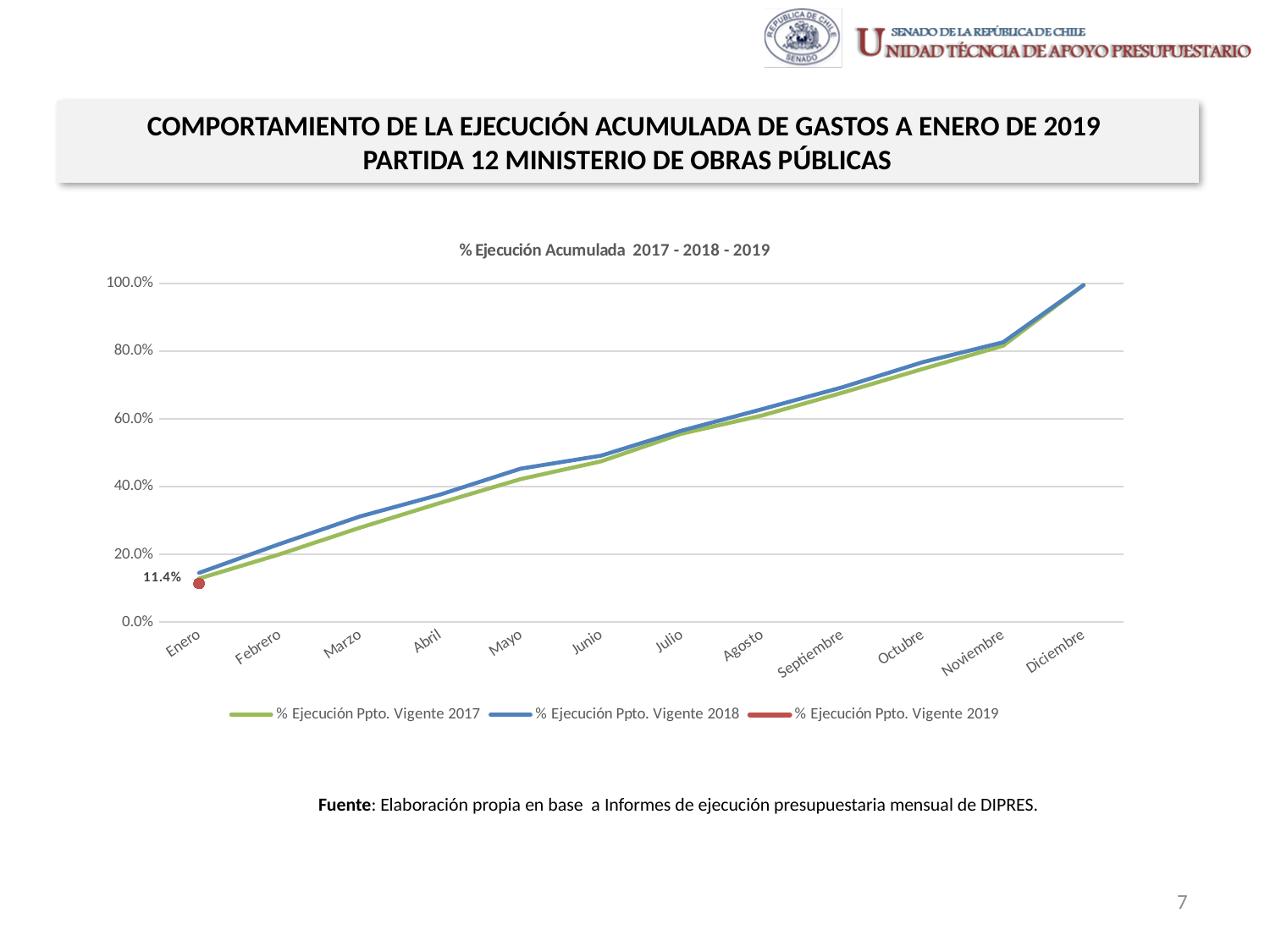
How many series does the legend list? 3 What kind of chart is shown on the slide? Line chart Do the values for % Ejecución Ppto. Vigente 2018 rise or fall from Enero to Diciembre? Rise In which month does % Ejecución Ppto. Vigente 2018 reach its highest value? Diciembre In which month is the value for % Ejecución Ppto. Vigente 2017 lowest? Enero What is the value for % Ejecución Ppto. Vigente 2019 in Enero? 11.4% Is the value for % Ejecución Ppto. Vigente 2018 in Mayo greater or less than 40.0%? greater In Mayo, which series has the higher value: % Ejecución Ppto. Vigente 2017 or % Ejecución Ppto. Vigente 2018? % Ejecución Ppto. Vigente 2018 Is the value for % Ejecución Ppto. Vigente 2018 in Diciembre greater or less than 80.0%? greater What is the title of the chart? % Ejecución Acumulada 2017 - 2018 - 2019 How many months are shown on the x axis of the chart? 12 Is the value for % Ejecución Ppto. Vigente 2017 in Marzo greater or less than 40.0%? less